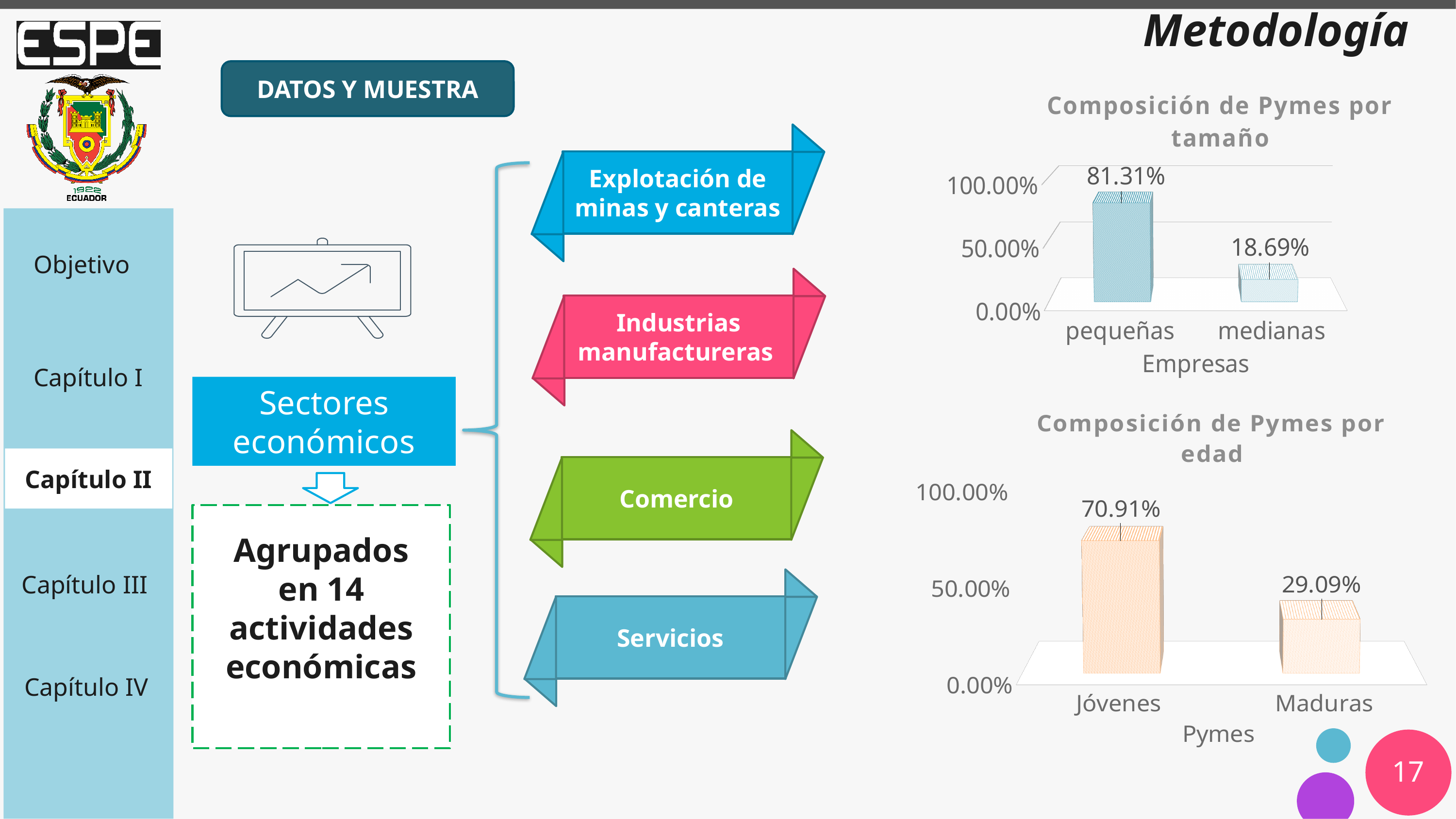
In the chart 'Composición de Pymes por tamaño', what is the difference between pequeñas and medianas? 62.62% In the chart 'Composición de Pymes por edad', what is the difference between Jóvenes and Maduras? 41.82% How many categories are shown in the chart 'Composición de Pymes por edad'? 2 In the chart 'Composición de Pymes por tamaño', what is the value for pequeñas? 81.31% In the chart 'Composición de Pymes por edad', what is the value for Maduras? 29.09% In the chart 'Composición de Pymes por edad', is the value for Maduras greater or less than 50.00%? less In the chart 'Composición de Pymes por tamaño', what is the x-axis title? Empresas In the chart 'Composición de Pymes por edad', which category has the lowest value? Maduras In the chart 'Composición de Pymes por edad', what is the value for Jóvenes? 70.91% In the chart 'Composición de Pymes por tamaño', what is the value for medianas? 18.69% In the chart 'Composición de Pymes por tamaño', which category has the highest value? pequeñas What kind of chart is 'Composición de Pymes por tamaño'? bar chart